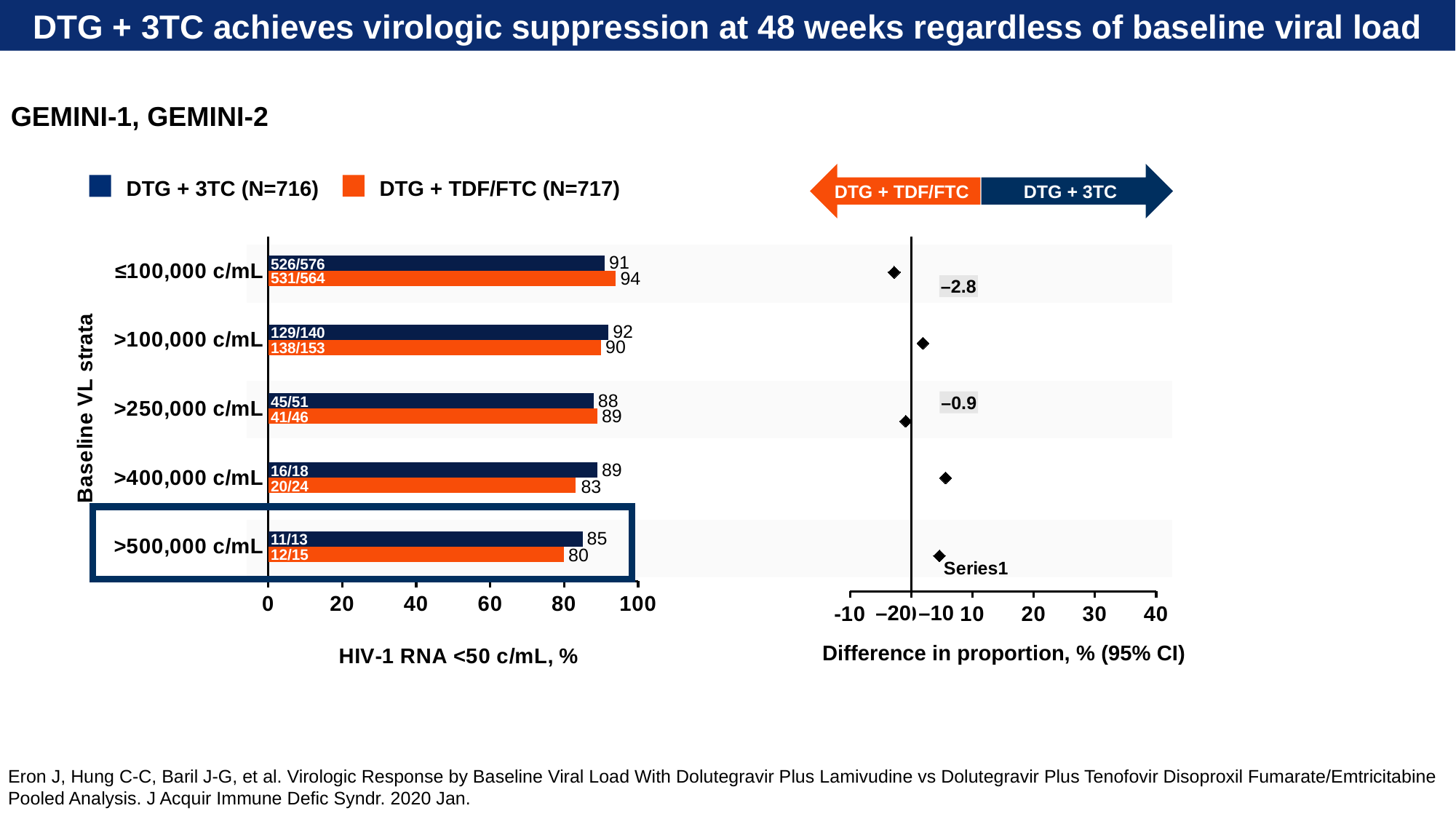
What is the x-axis title of the right chart? Difference in proportion, % (95% CI) What type of chart is the left chart on the slide? Bar chart In the left bar chart, for the ≤100,000 c/mL stratum, which series has the larger value, DTG + 3TC or DTG + TDF/FTC? DTG + TDF/FTC In the left bar chart, what is the DTG + 3TC value for the ≤100,000 c/mL stratum? 91 In the left bar chart, is the DTG + 3TC value for the >500,000 c/mL stratum greater or less than 80? greater In the left bar chart, which baseline VL stratum has the highest DTG + 3TC value? >100,000 c/mL In the left bar chart, what is the difference between the DTG + 3TC and DTG + TDF/FTC values for the >400,000 c/mL stratum? 6 In the left bar chart, what is the DTG + TDF/FTC value for the >500,000 c/mL stratum? 80 In the left bar chart, what is the DTG + TDF/FTC value for the >400,000 c/mL stratum? 83 In the left bar chart, which baseline VL stratum has the lowest DTG + TDF/FTC value? >500,000 c/mL How many baseline VL strata are shown in the left bar chart? 5 How many series does the legend of the left bar chart list? 2